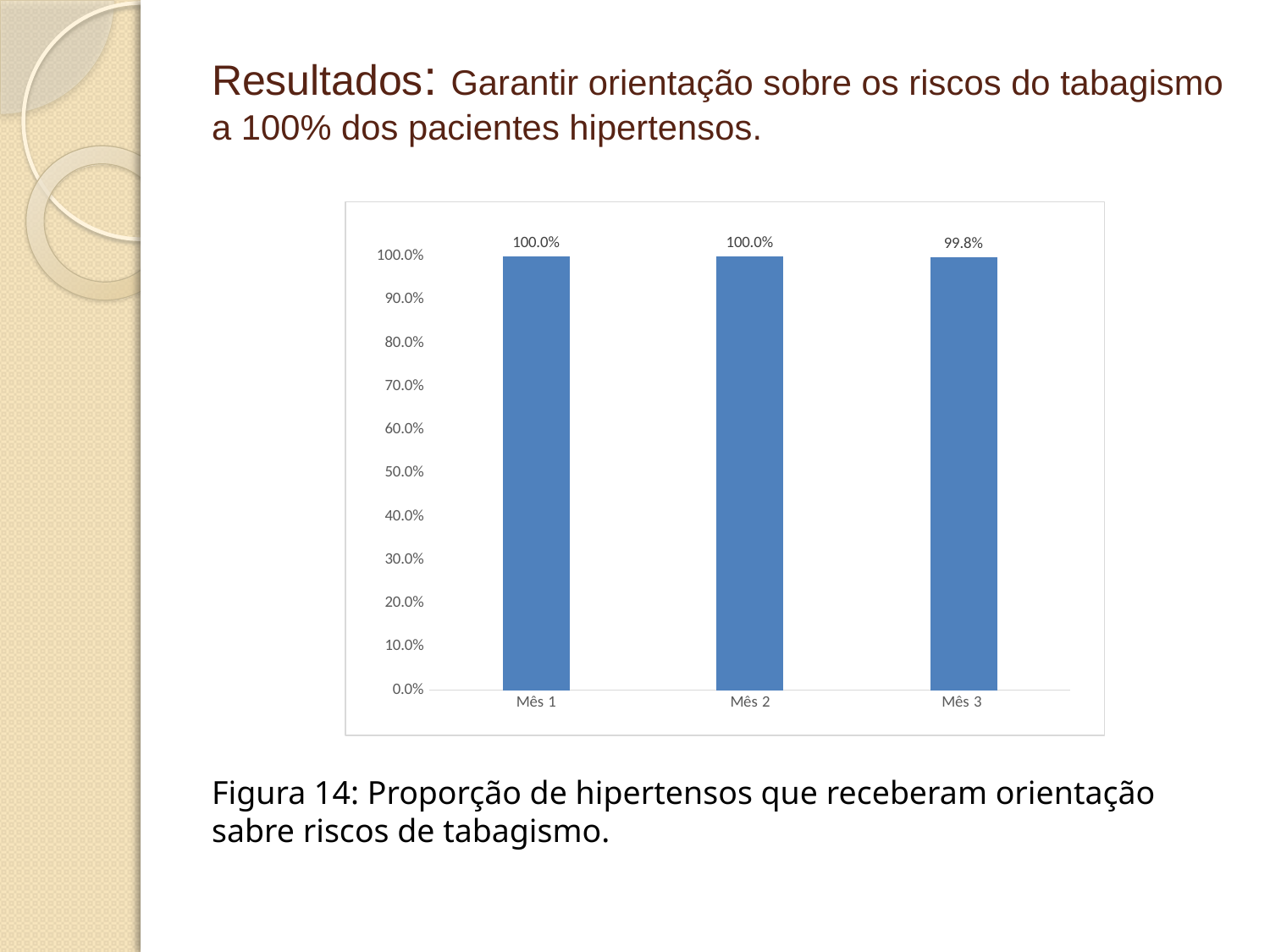
What is the highest value printed on the y axis? 100.0% What kind of chart is shown on the slide? bar chart What is the difference between the values for Mês 1 and Mês 3? 0.2% Is the value for Mês 3 greater or less than 90.0%? greater What is the value for Mês 3? 99.8% Do the values rise, fall or stay roughly the same from Mês 1 to Mês 3? stay roughly the same Which month has the lowest value? Mês 3 What is the value for Mês 1? 100.0% How many months are shown on the x axis? 3 What colour are the bars in the chart? blue What is the value for Mês 2? 100.0%